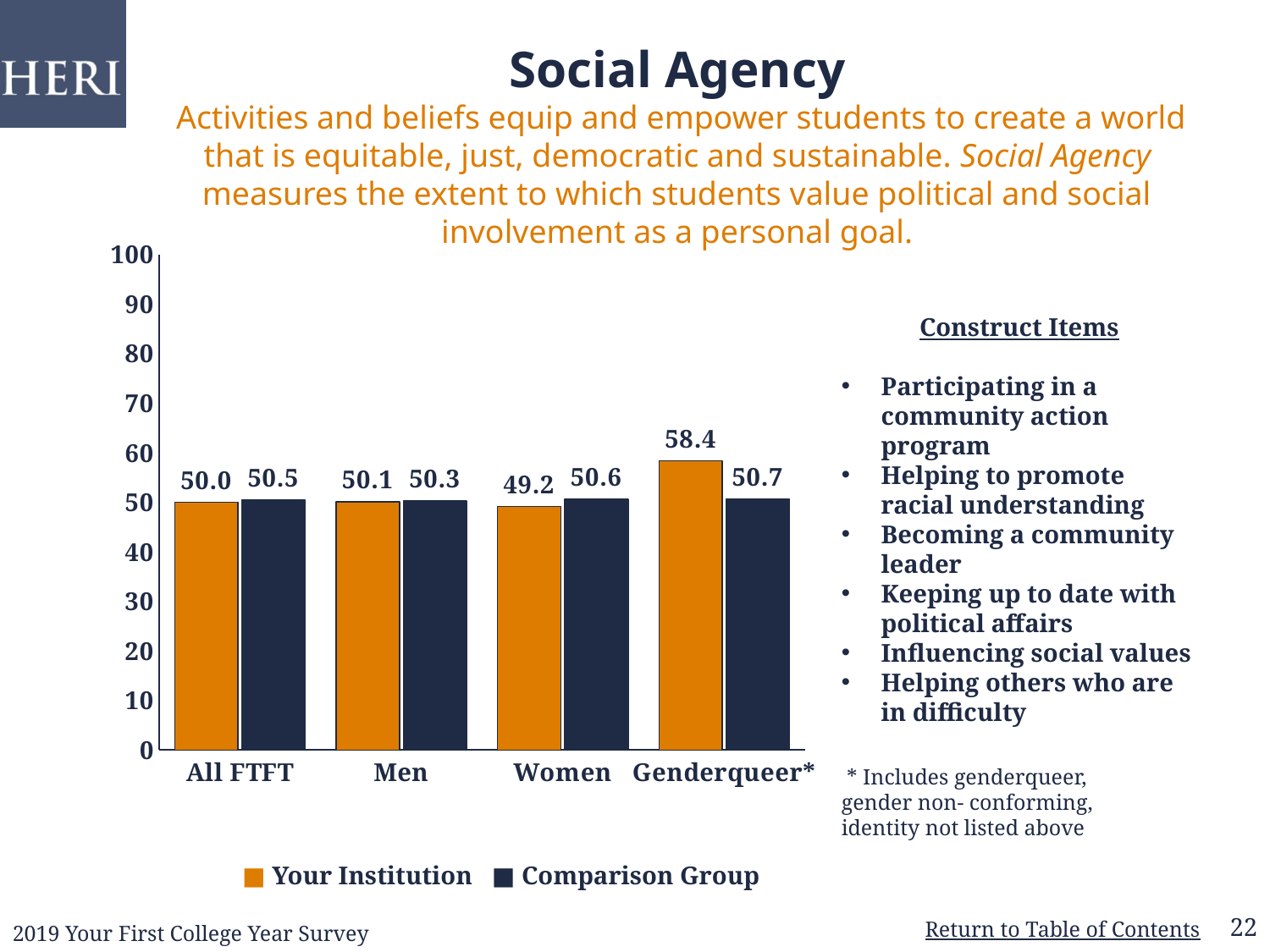
What is the Comparison Group value for Women? 50.6 How many categories are shown on the x axis? 4 For Men, which is larger: Your Institution or Comparison Group? Comparison Group How many series does the legend list? 2 What is the difference between the Comparison Group and Your Institution values for Women? 1.4 Is the Your Institution value for Genderqueer* greater or less than 50? greater What kind of chart is shown on the slide? bar chart What is the Your Institution value for Genderqueer*? 58.4 What is the difference between the Your Institution and Comparison Group values for Genderqueer*? 7.7 Which category has the lowest Your Institution value? Women What is the Your Institution value for All FTFT? 50.0 Which category has the highest Your Institution value? Genderqueer*